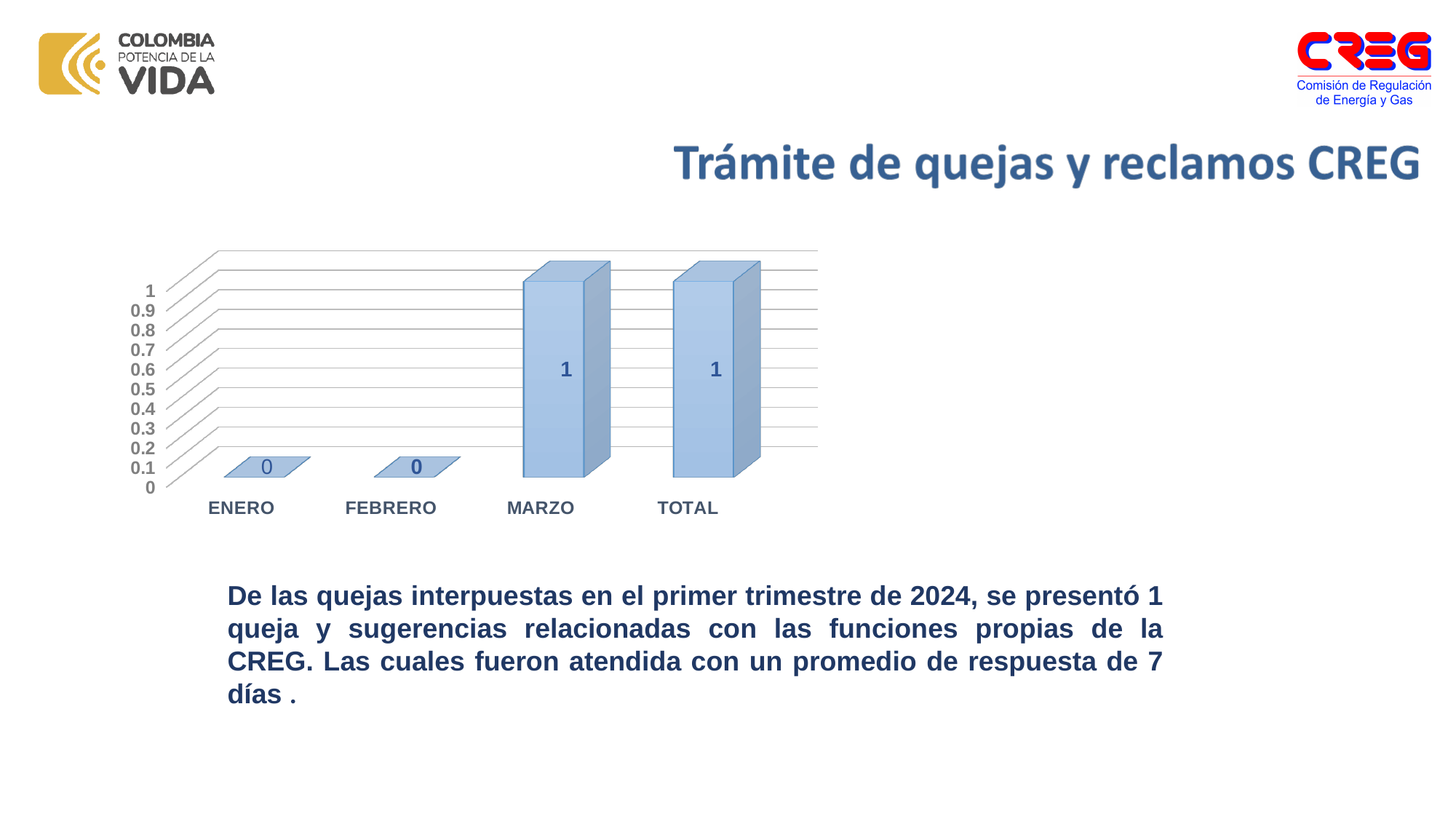
Which month has the highest value? MARZO Do the values rise or fall from ENERO to MARZO? rise What is the value for TOTAL? 1 What kind of chart is shown on the slide? bar chart How many categories are shown on the x axis? 4 Which is larger, the value for ENERO or the value for MARZO? MARZO What is the value for FEBRERO? 0 What is the difference between the values for MARZO and FEBRERO? 1 What is the highest value shown on the y axis? 1 What is the value for ENERO? 0 What is the value for MARZO? 1 What is the title of the slide containing the chart? Trámite de quejas y reclamos CREG